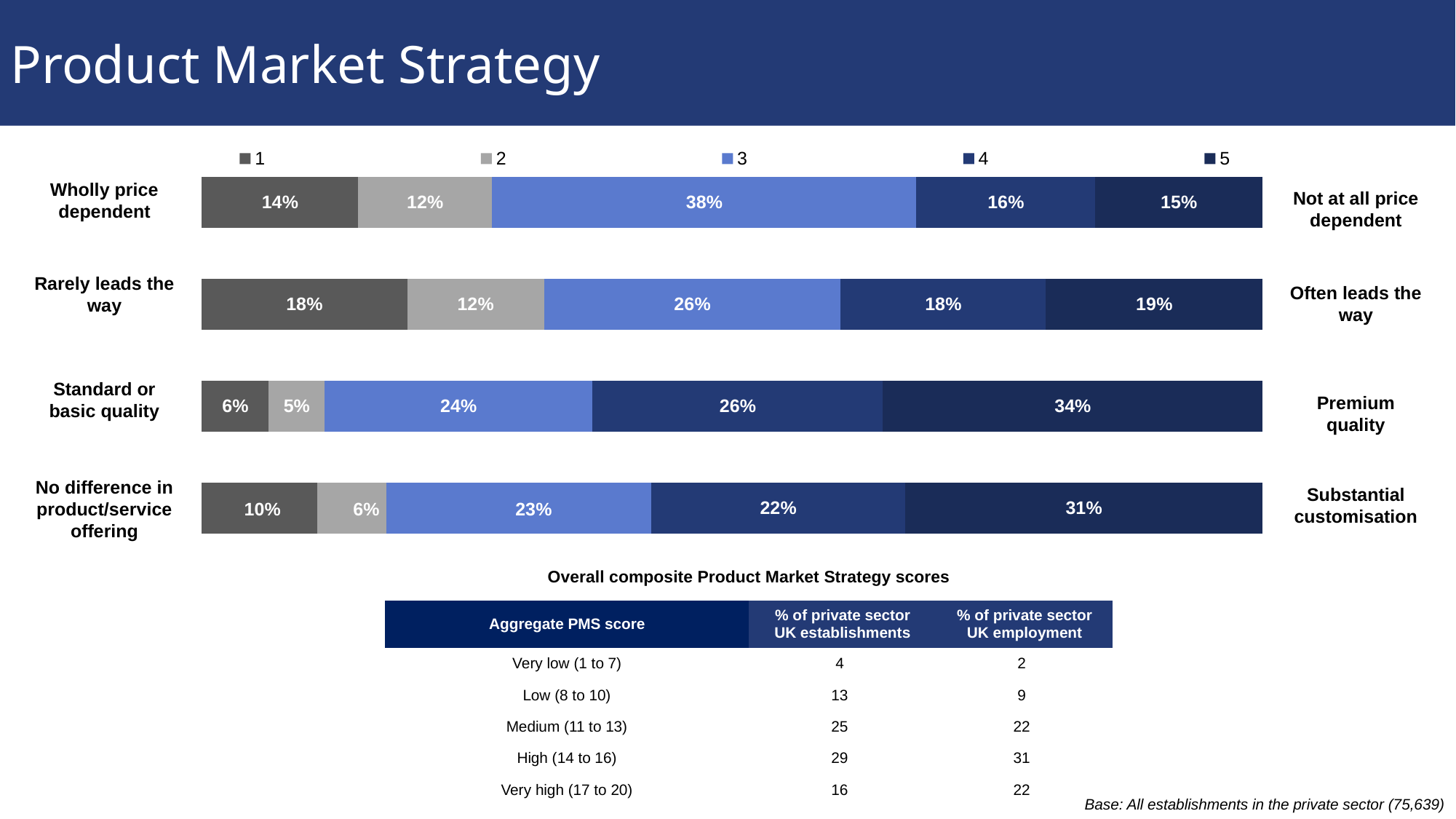
In the 'No difference in product/service offering / Substantial customisation' bar, which series has the largest segment? 5 In the stacked bar chart, what percentage is shown for series 5 in the 'Standard or basic quality / Premium quality' bar? 34% In the 'Standard or basic quality / Premium quality' bar, which is larger: the series 1 segment or the series 5 segment? Series 5 In the 'Wholly price dependent / Not at all price dependent' bar, what is the difference between the series 3 value and the series 2 value? 26 percentage points In the stacked bar chart, what percentage is shown for series 3 in the 'Wholly price dependent / Not at all price dependent' bar? 38% How many stacked bars are shown in the chart? 4 How many series does the legend of the stacked bar chart list? 5 In the stacked bar chart, what percentage is shown for series 4 in the 'No difference in product/service offering / Substantial customisation' bar? 22% In the 'Standard or basic quality / Premium quality' bar, which series has the smallest segment? 2 What are the entries listed in the chart's legend? 1, 2, 3, 4, 5 In the stacked bar chart, what percentage is shown for series 1 in the 'Rarely leads the way / Often leads the way' bar? 18% What kind of chart is used to show the Product Market Strategy ratings? Stacked bar chart